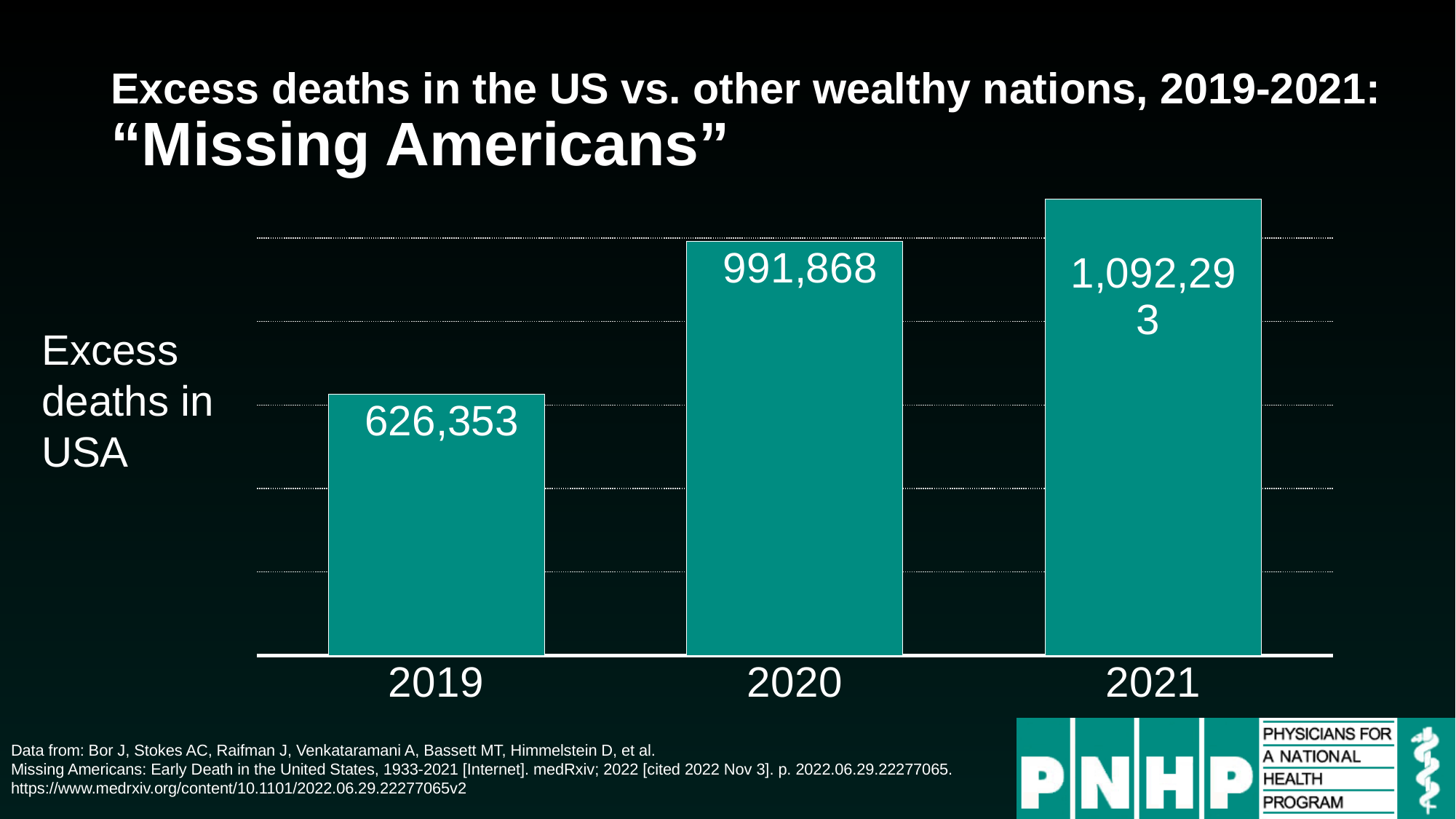
What is the value of excess deaths in the USA for 2021? 1,092,293 What kind of chart is shown on the slide? Bar chart What is the difference in excess deaths between 2020 and 2019? 365,515 Do the excess deaths rise or fall from 2019 to 2021? Rise What is the difference in excess deaths between 2021 and 2020? 100,425 Which year has the lowest number of excess deaths? 2019 What is the difference in excess deaths between 2021 and 2019? 465,940 What is the value of excess deaths in the USA for 2019? 626,353 What is the value of excess deaths in the USA for 2020? 991,868 Which year has more excess deaths, 2019 or 2020? 2020 Which year has the highest number of excess deaths? 2021 How many years are shown on the x axis of the chart? 3